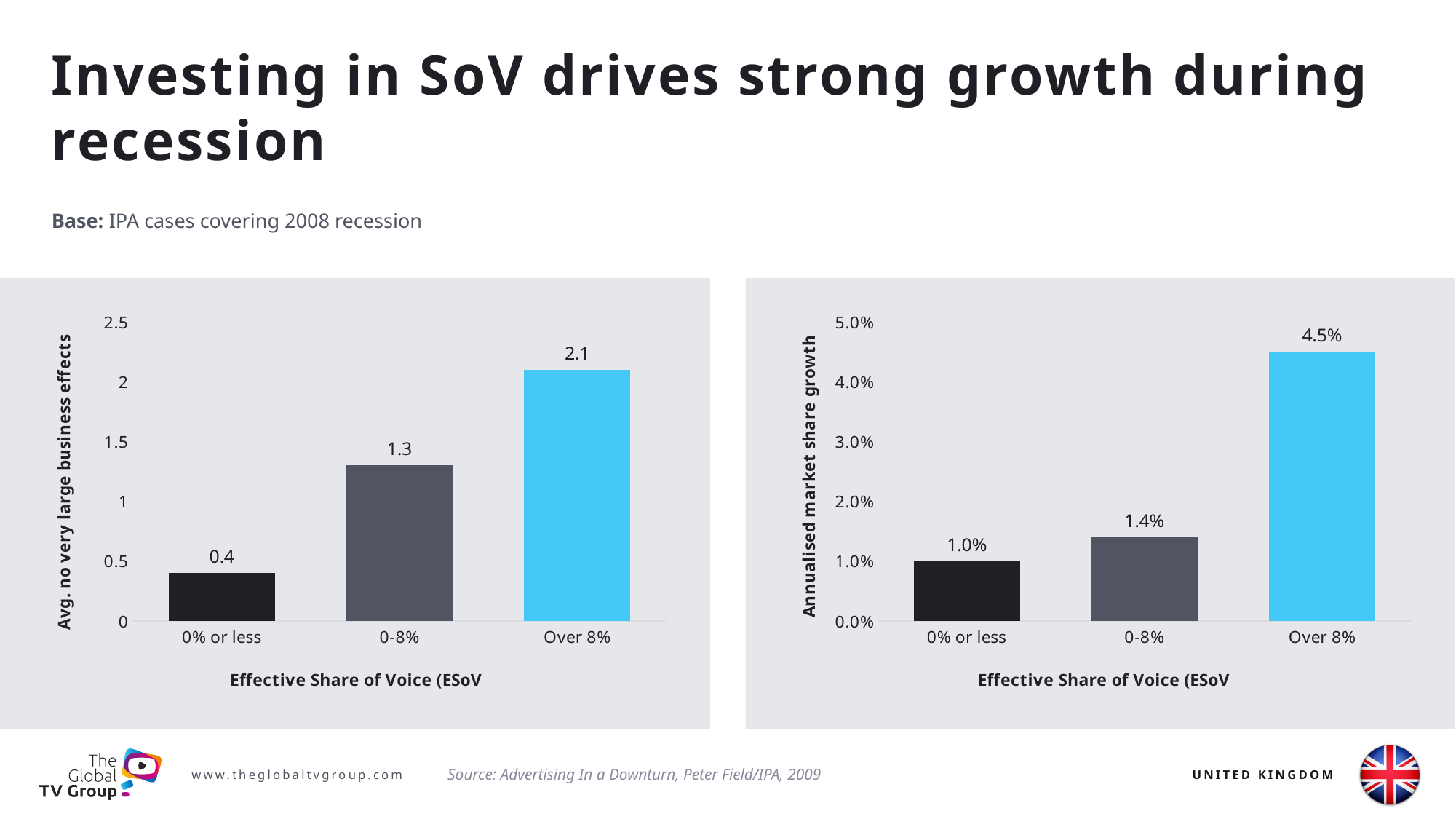
In the right chart (Annualised market share growth), which is larger: the value for '0-8%' or for '0% or less'? 0-8% How many ESoV categories are shown in the left chart (Avg. no very large business effects)? 3 What type of chart is the right chart (Annualised market share growth)? Bar chart In the left chart (Avg. no very large business effects), what is the value for 'Over 8%'? 2.1 In the right chart (Annualised market share growth), what is the value for '0% or less'? 1.0% In the left chart (Avg. no very large business effects), what is the difference between the values for 'Over 8%' and '0% or less'? 1.7 In the left chart (Avg. no very large business effects), which ESoV category has the lowest value? 0% or less In the left chart (Avg. no very large business effects), do the values rise or fall as ESoV increases from '0% or less' to 'Over 8%'? Rise In the right chart (Annualised market share growth), which ESoV category has the highest value? Over 8% In the right chart (Annualised market share growth), what is the value for 'Over 8%'? 4.5% In the left chart (Avg. no very large business effects), what is the value for '0-8%'? 1.3 In the right chart (Annualised market share growth), what is the difference between the values for 'Over 8%' and '0-8%'? 3.1%